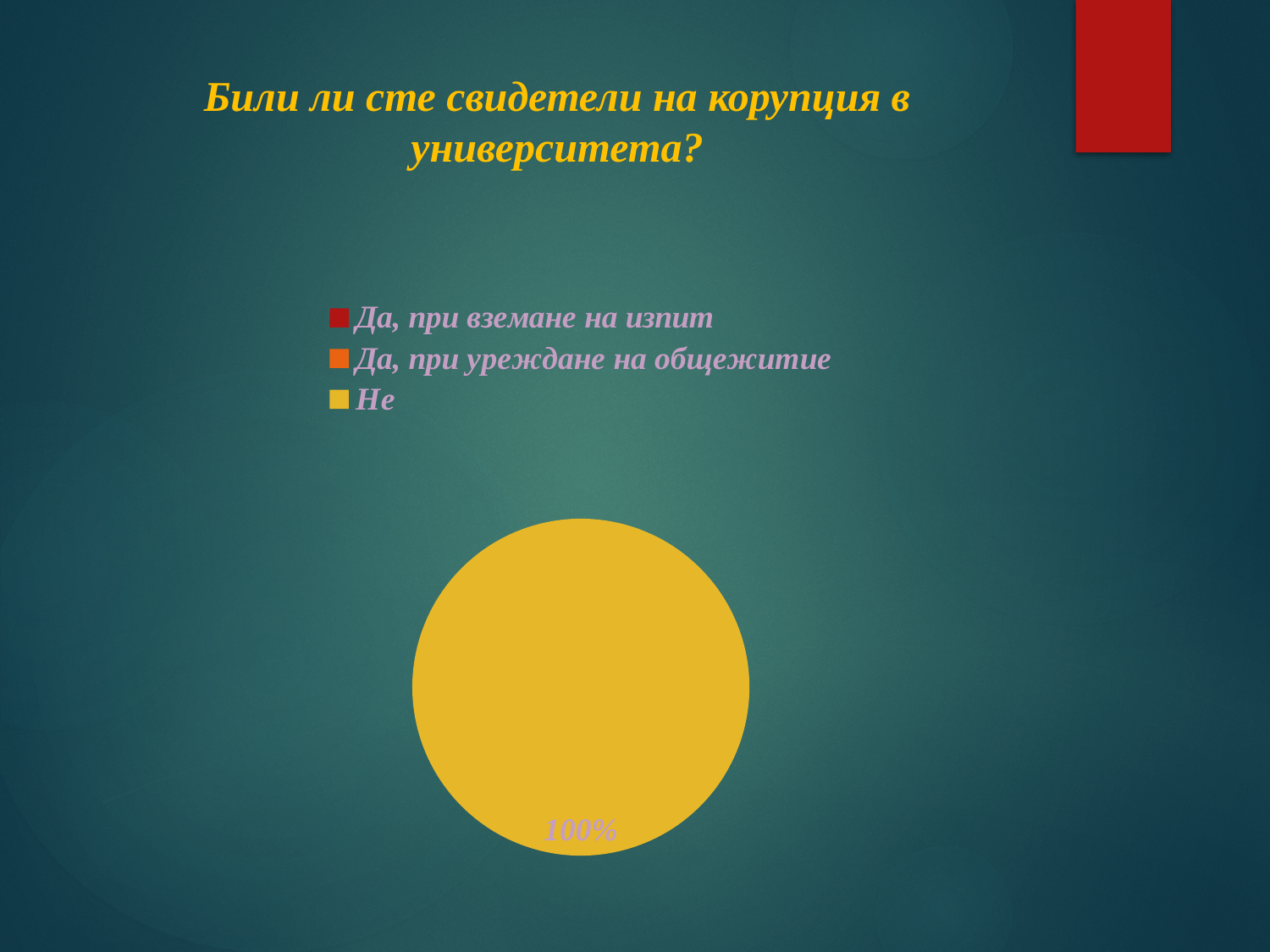
How many entries does the legend list? 3 What is the data label printed on the pie chart? 100% What kind of chart is shown on the slide? pie chart What is the title of the chart? Били ли сте свидетели на корупция в университета? Which category has the largest share of the pie? Не Which legend entry is listed first? Да, при вземане на изпит What colour is the "Не" slice of the pie? yellow What share of the pie does the "Не" slice take? 100% Is the share for "Не" greater or less than 50%? greater